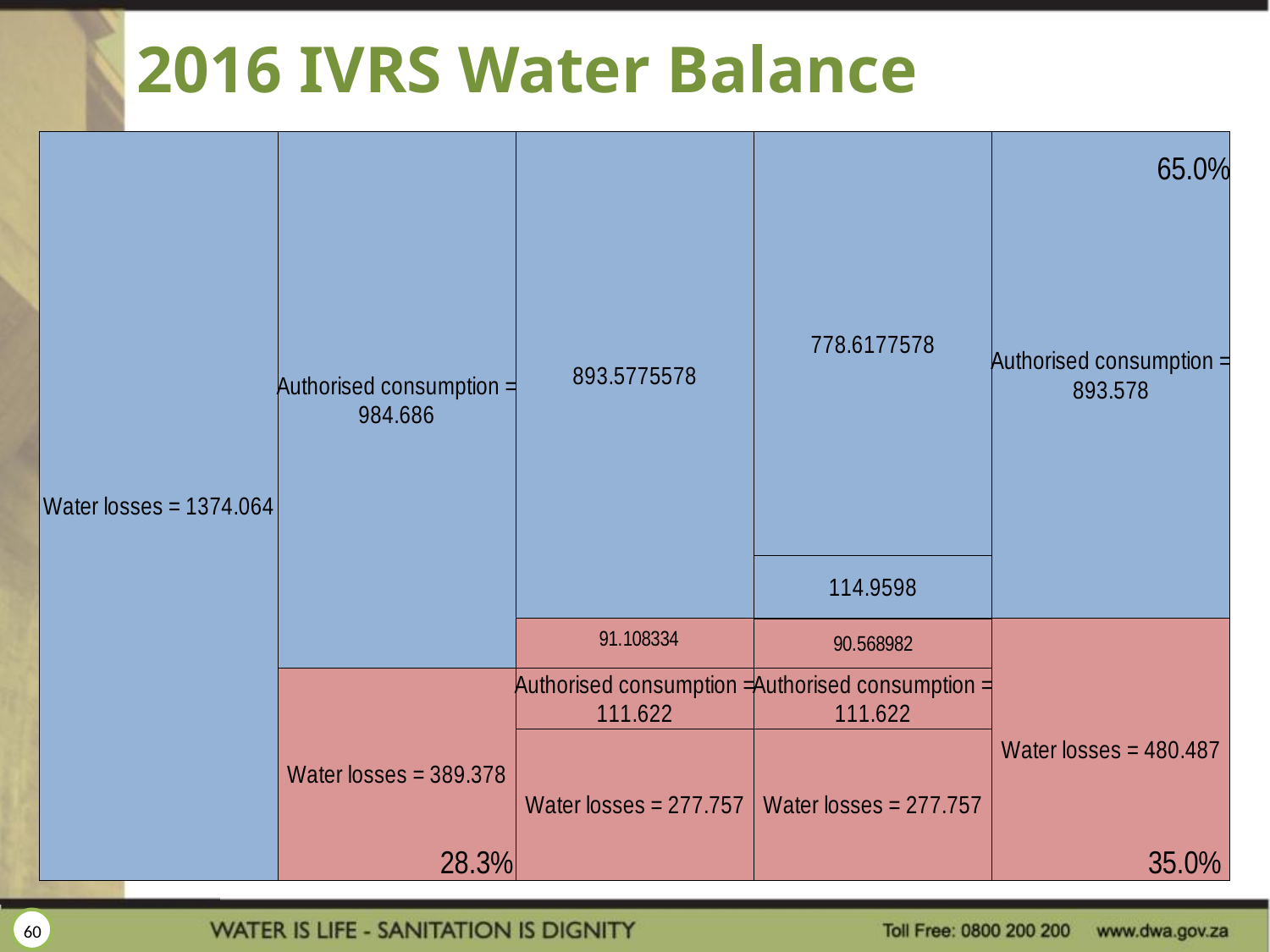
What is the title of the chart? 2016 IVRS Water Balance What is the value of Water losses in the rightmost column? 480.487 What is the total of Authorised consumption (984.686) and Water losses (389.378) in the second column from the left? 1374.064 What is the value of Authorised consumption in the rightmost column? 893.578 What percentage is shown at the bottom of the second column from the left? 28.3% What is the value of Authorised consumption in the second column from the left? 984.686 What is the value of Water losses in the second column from the left? 389.378 What kind of chart is shown on the slide? stacked bar chart In the second column from the left, which is larger: Authorised consumption or Water losses? Authorised consumption What percentage is shown at the top of the rightmost column? 65.0% What is the difference between Authorised consumption (984.686) and Water losses (389.378) in the second column from the left? 595.308 What is the value of Water losses shown in the leftmost column? 1374.064